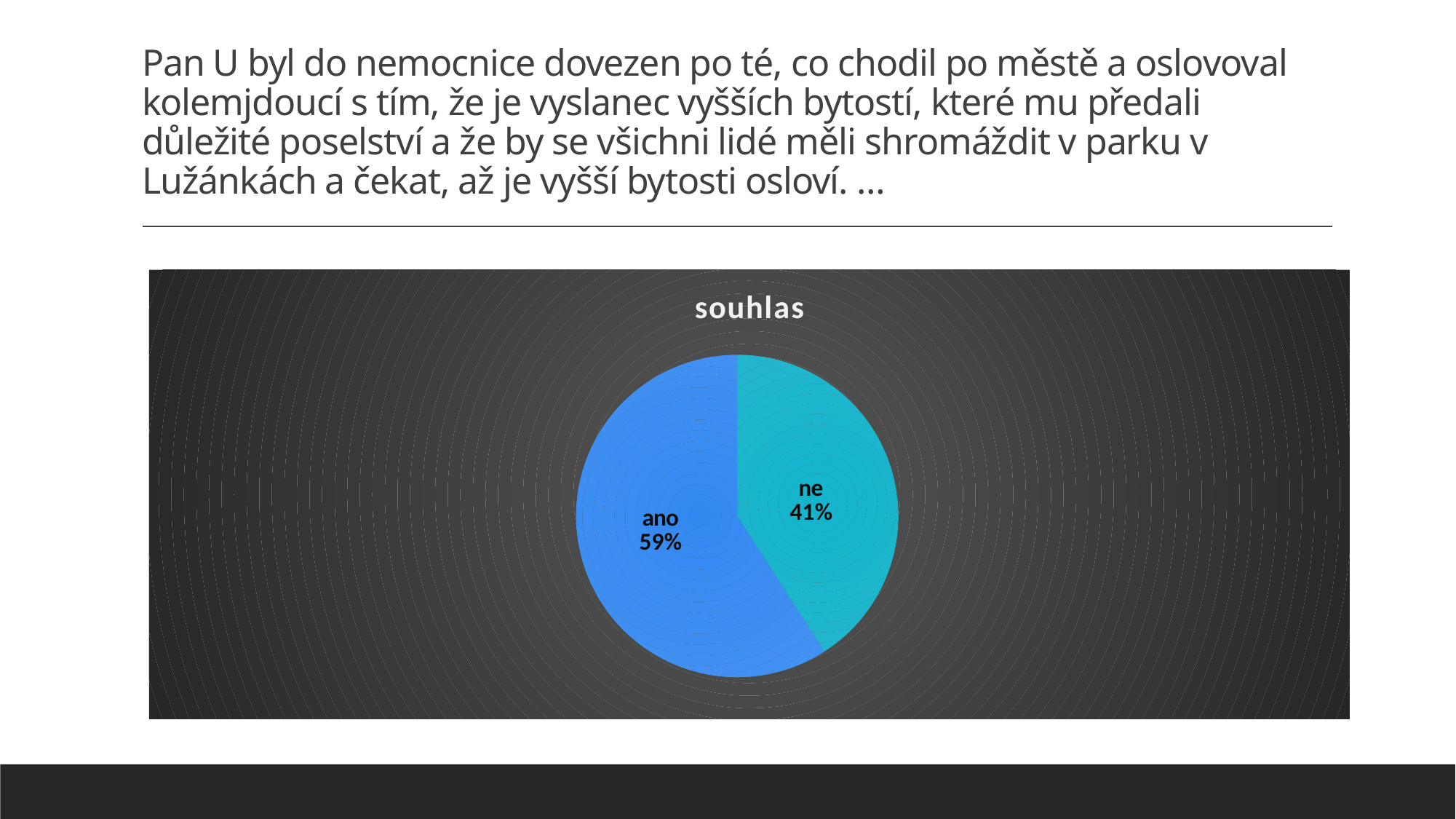
Which is larger, the "ano" slice or the "ne" slice? ano What colour is the "ano" slice? blue How many slices does the pie chart have? 2 What is the title of the chart? souhlas What is the difference in percentage points between the "ano" and "ne" slices? 18 What kind of chart is shown on the slide? pie chart Which slice is the largest in the pie chart? ano Which slice is the smallest in the pie chart? ne What share of the pie does the "ne" slice represent? 41% What share of the pie does the "ano" slice represent? 59% Is the value for "ne" greater or less than 50%? less